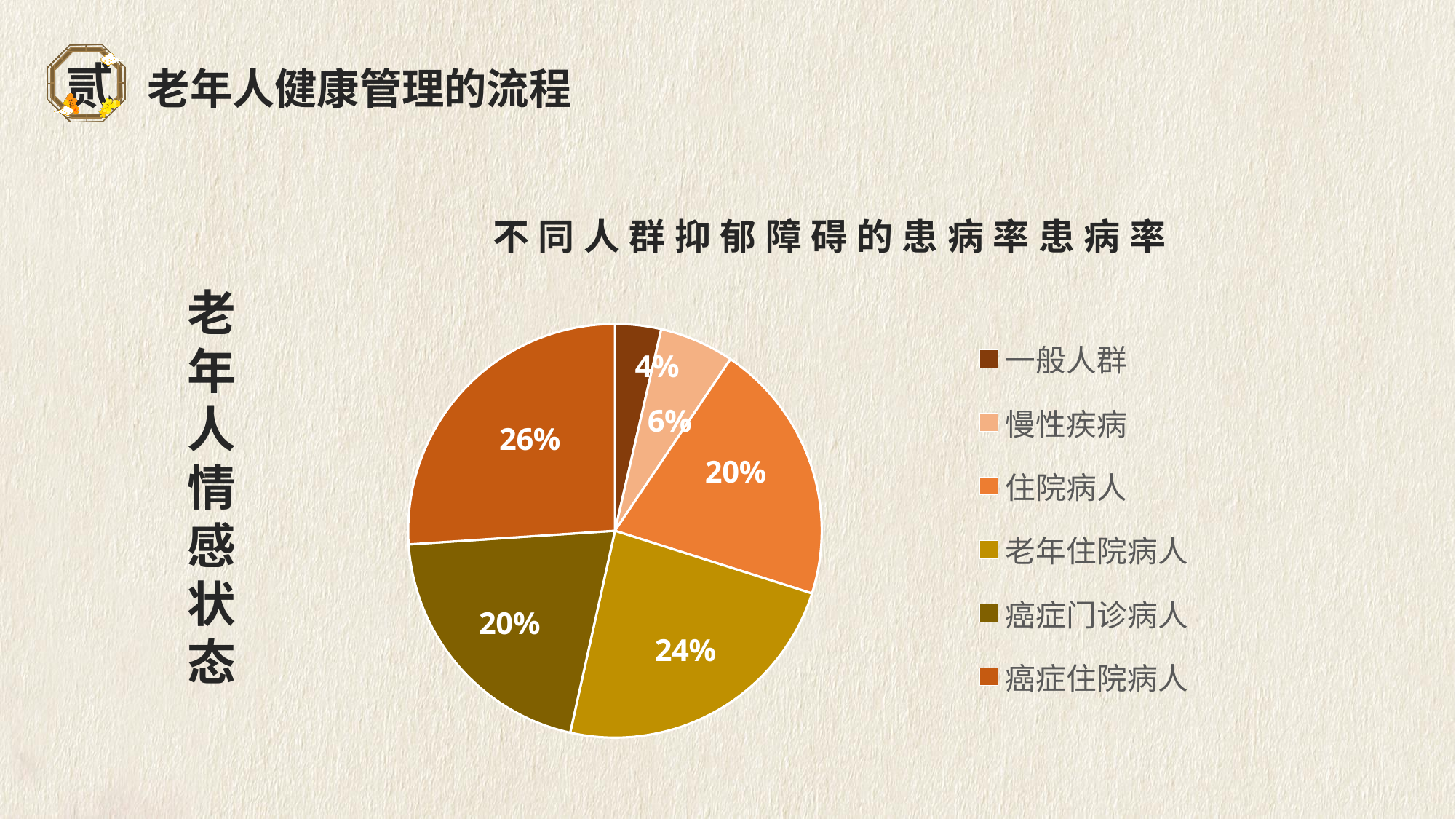
Which category has the largest share of the pie chart? 癌症住院病人 How many categories does the pie chart have? 6 What is the difference between the values for 癌症住院病人 and 老年住院病人? 2% What is the value for 慢性疾病 in the pie chart? 6% Which two categories in the pie chart both have a value of 20%? 住院病人 and 癌症门诊病人 What is the value for 老年住院病人 in the pie chart? 24% What is the value for 一般人群 in the pie chart? 4% What kind of chart is shown on the slide? Pie chart What is the title of the pie chart? 不同人群抑郁障碍的患病率患病率 Which category has the smallest share of the pie chart? 一般人群 Which is larger, the value for 住院病人 or the value for 慢性疾病? 住院病人 What is the value for 癌症住院病人 in the pie chart? 26%